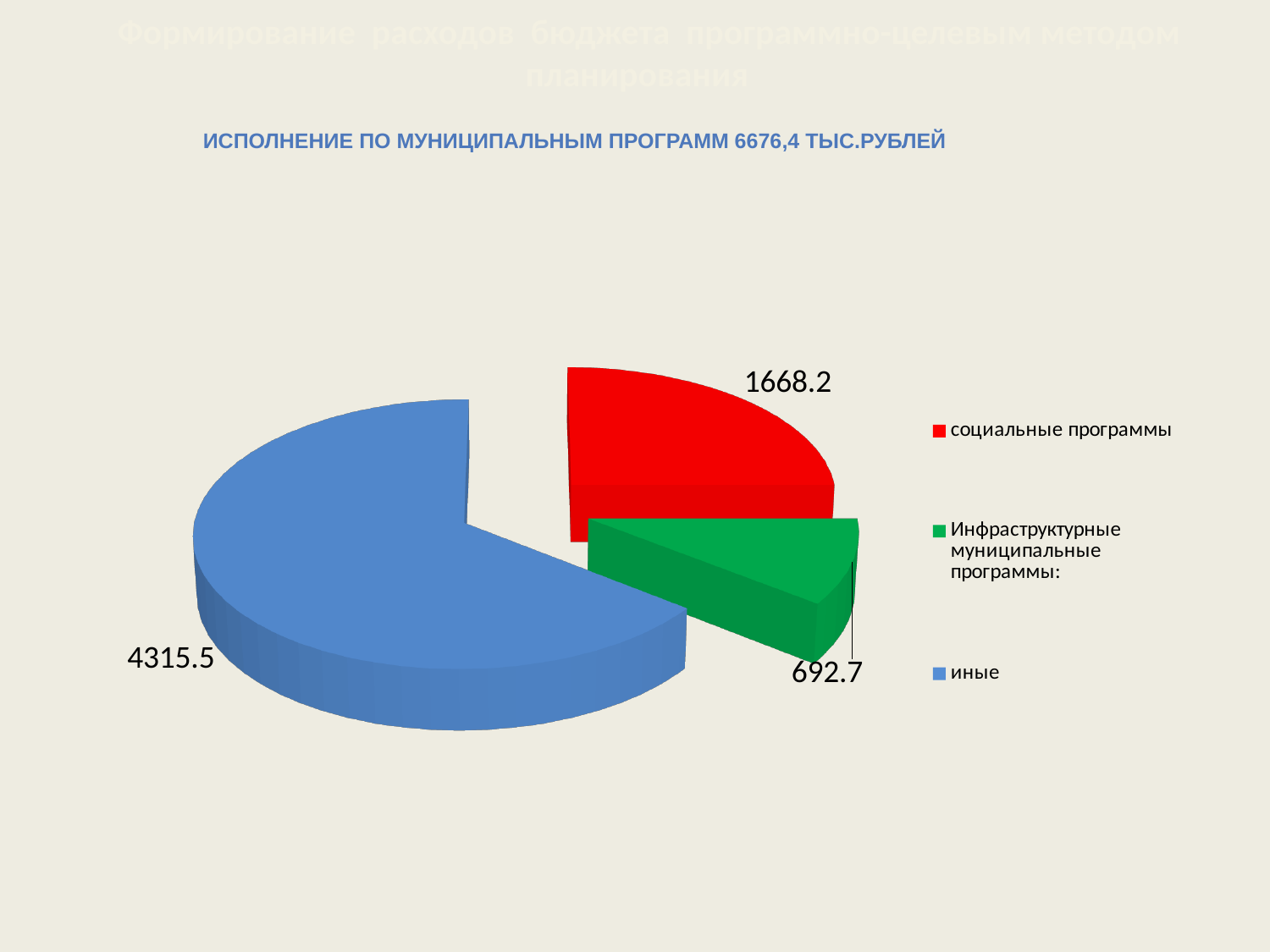
What is the difference between the values for иные and социальные программы? 2647.3 How many slices does the pie chart have? 3 What is the difference between the values for социальные программы and Инфраструктурные муниципальные программы? 975.5 Which category has the largest slice of the pie? иные What colour is the slice for социальные программы? Red What is the value for Инфраструктурные муниципальные программы? 692.7 What is the value for социальные программы? 1668.2 What kind of chart is shown on the slide? Pie chart Which category has the smallest slice of the pie? Инфраструктурные муниципальные программы What share of the pie does the иные slice represent, to the nearest whole percent? 65% Which is larger, the value for социальные программы or the value for Инфраструктурные муниципальные программы? социальные программы What is the value for иные? 4315.5